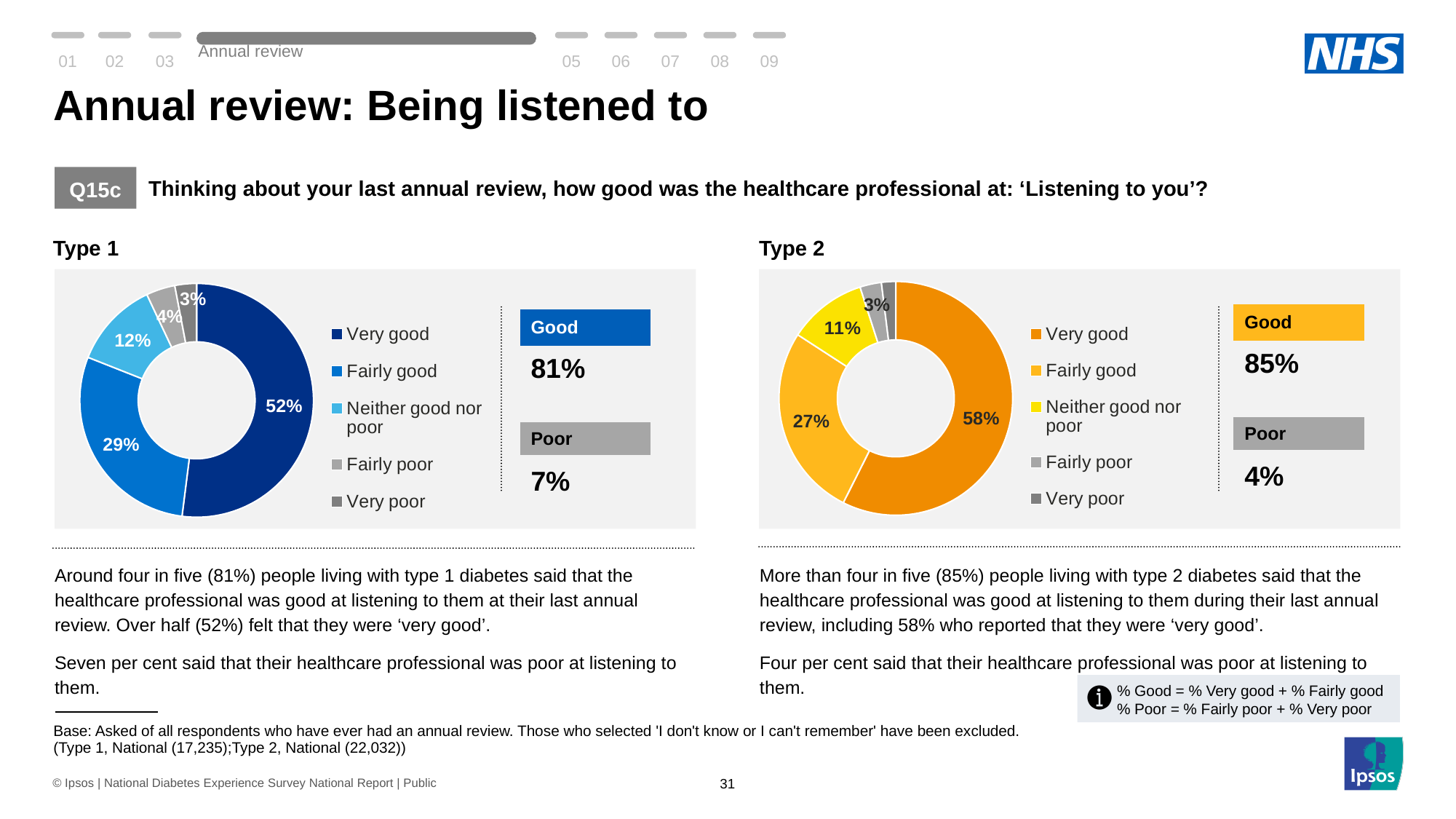
In the Type 2 chart, what percentage of respondents answered 'Fairly poor'? 3% Which is larger: the 'Fairly good' share in the Type 1 chart or in the Type 2 chart? Type 1 In the Type 1 chart, what percentage of respondents said the healthcare professional was 'Very good' at listening to them? 52% What type of chart is used to show the Type 2 results? Donut (pie) chart What is the difference between the 'Very good' percentages in the Type 2 chart and the Type 1 chart? 6 percentage points In the Type 2 chart, what percentage of respondents said the healthcare professional was 'Fairly good' at listening to them? 27% In the Type 1 chart, which response category has the largest share? Very good What is the combined 'Poor' percentage shown for the Type 1 chart? 7% How many response categories does the legend of the Type 1 chart list? 5 In the Type 1 chart, what percentage of respondents answered 'Neither good nor poor'? 12% In the Type 1 chart, which response category has the smallest share? Very poor What is the combined 'Good' percentage shown for the Type 2 chart? 85%